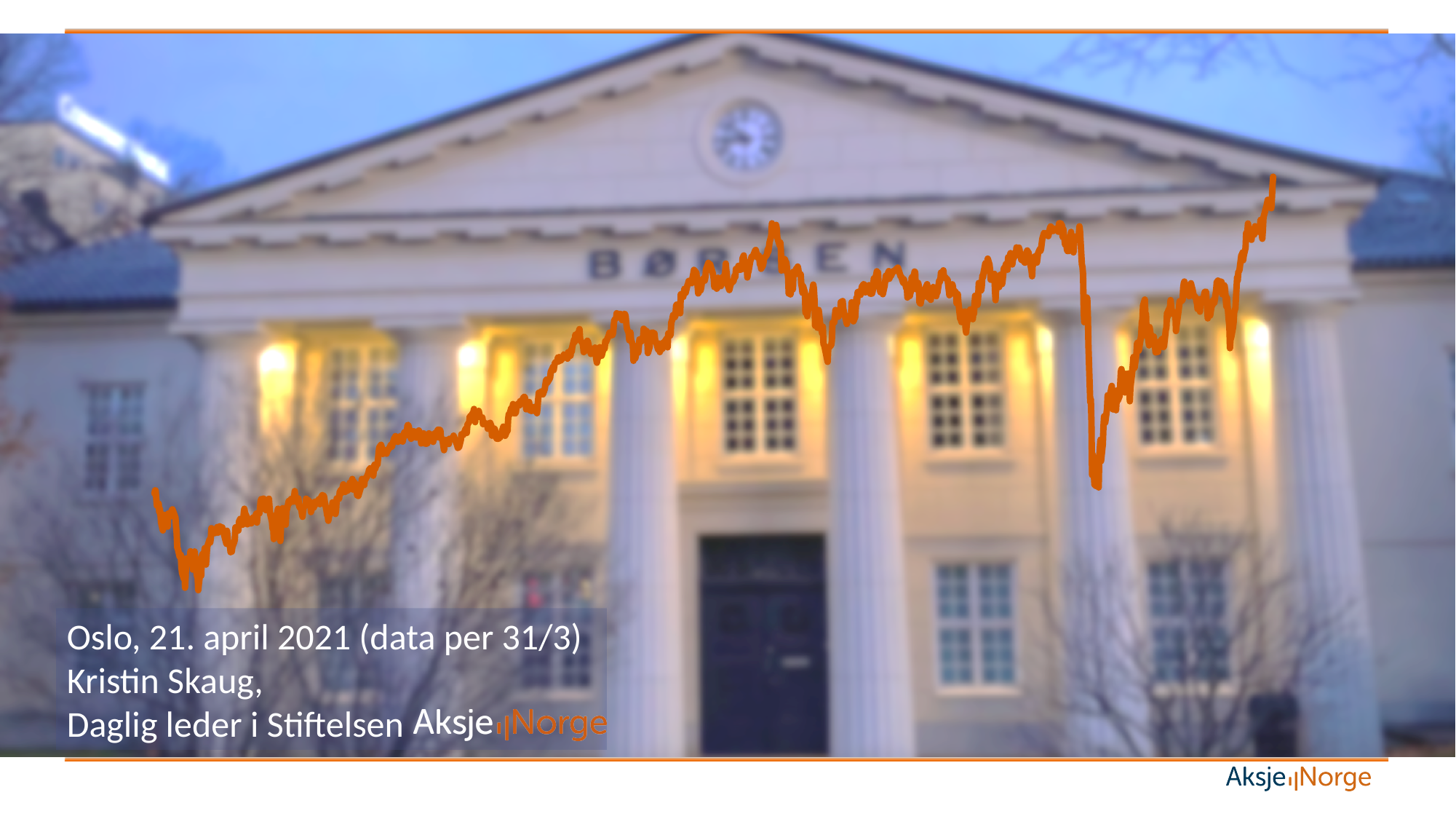
How many lines are plotted on the chart? 1 Does the chart show any axis labels or numeric values? no Does the line on the chart generally rise or fall from left to right? rise What kind of chart is overlaid on the slide? line chart What colour is the line plotted on the chart? orange